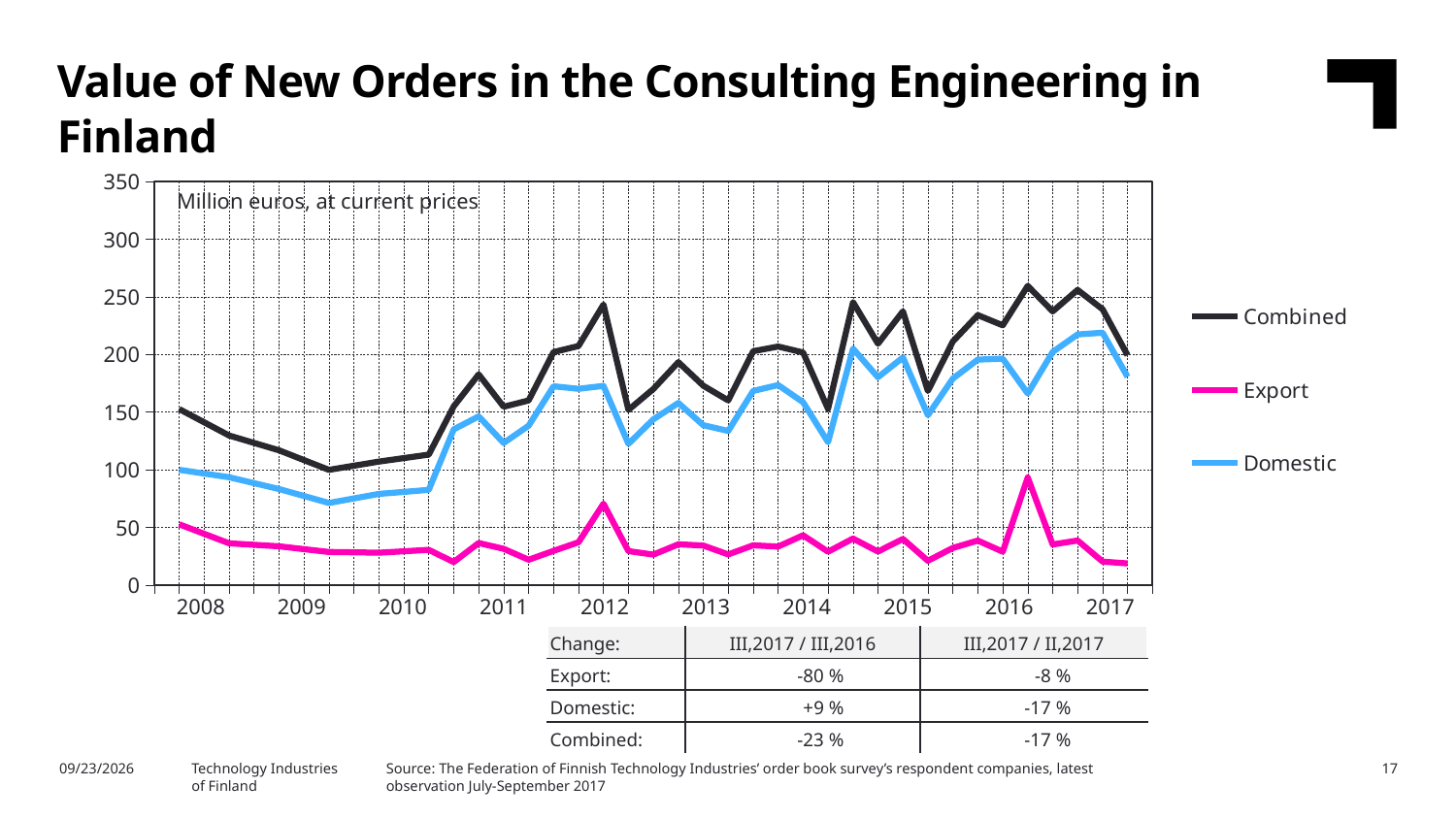
Which series has the highest values throughout the chart? Combined Is the peak value of the Export series in 2012 greater or less than 50? greater Is the final Domestic value in 2017 greater or less than 200? less Is the peak value of the Combined series in 2012 greater or less than 200? greater What unit is stated in the chart's annotation? Million euros, at current prices Does the Combined series rise or fall from 2008 to 2009? Fall What kind of chart is shown on the slide? Line chart Which series has the lowest values throughout the chart? Export How many series does the legend list? 3 According to the table, what is the Export change for III,2017 / III,2016? -80 % In 2015, which series is higher, Domestic or Export? Domestic